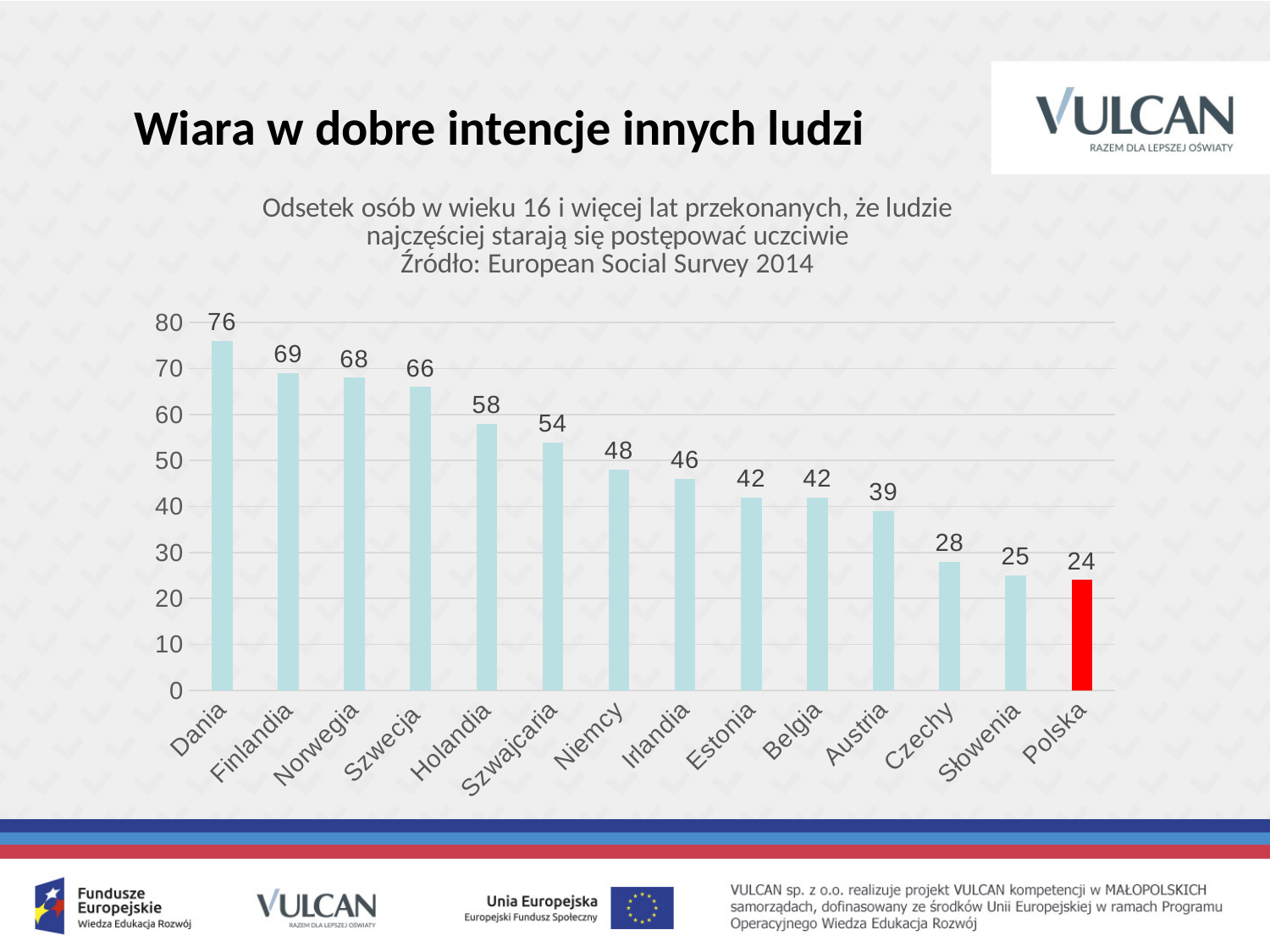
What is the value for Dania? 76 Which bar is coloured red? Polska What is the difference between the values for Dania and Polska? 52 What is the difference between the values for Finlandia and Norwegia? 1 How many countries are shown on the chart? 14 Which country has the lowest value? Polska What is the value for Polska? 24 What is the value for Holandia? 58 Which is larger, the value for Szwajcaria or the value for Niemcy? Szwajcaria Which country has the highest value? Dania What kind of chart is this? bar chart Do the values rise or fall from left to right along the x axis? fall